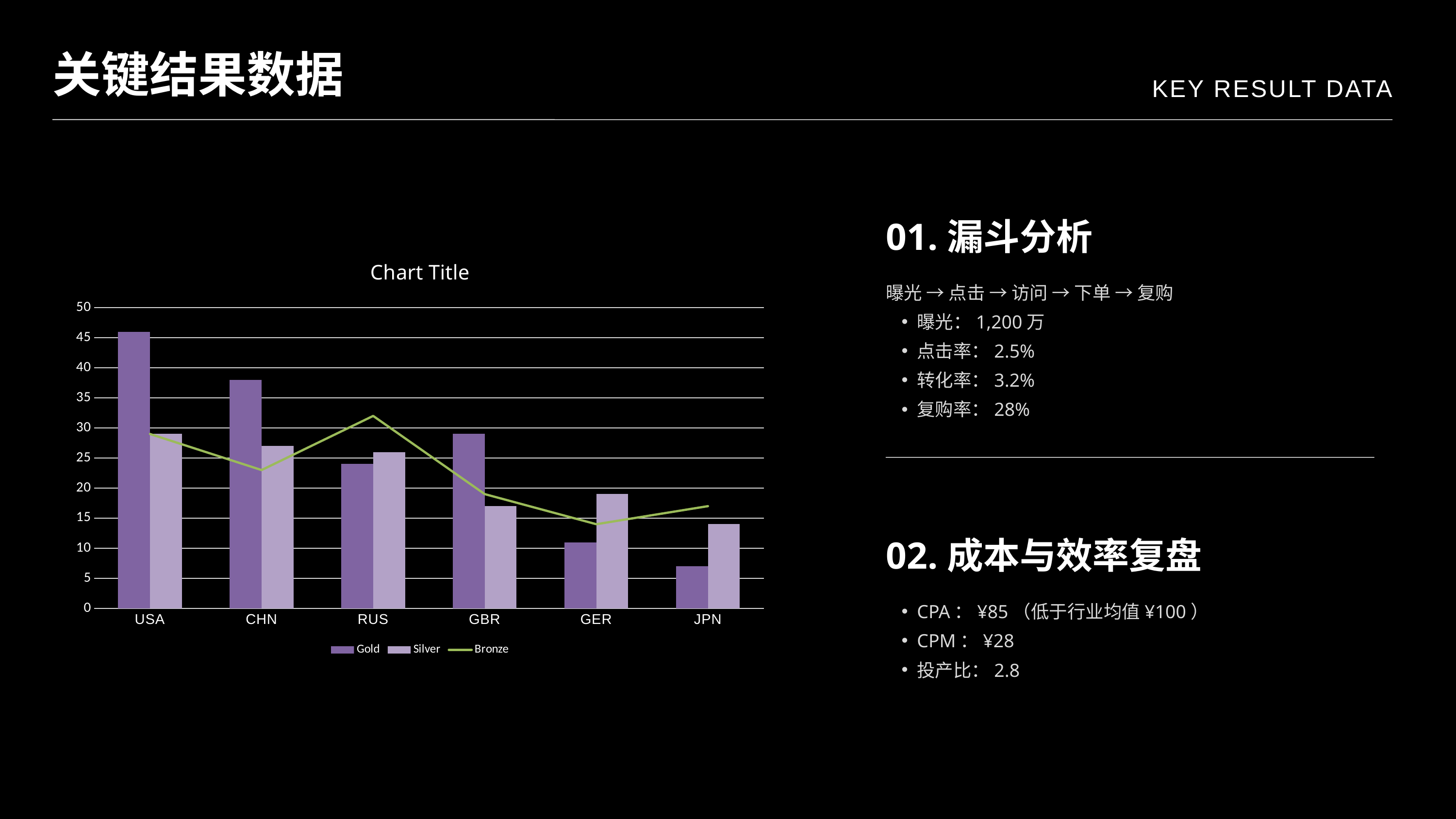
Which is larger for GER, the Gold value or the Silver value? Silver Which country has the lowest Gold value in the chart? JPN How many countries are shown on the x axis of the chart? 6 What are the three series named in the chart legend? Gold, Silver, Bronze Which country has the lowest Silver value in the chart? JPN What kind of chart is shown on the slide? Bar chart with a line series Is the Bronze value for RUS greater or less than 30? greater How many series does the chart legend list? 3 Which is larger, the Gold value for USA or the Gold value for CHN? USA Which country has the highest Gold value in the chart? USA Is the Gold value for USA greater or less than 40? greater Is the Gold value for GER greater or less than 15? less